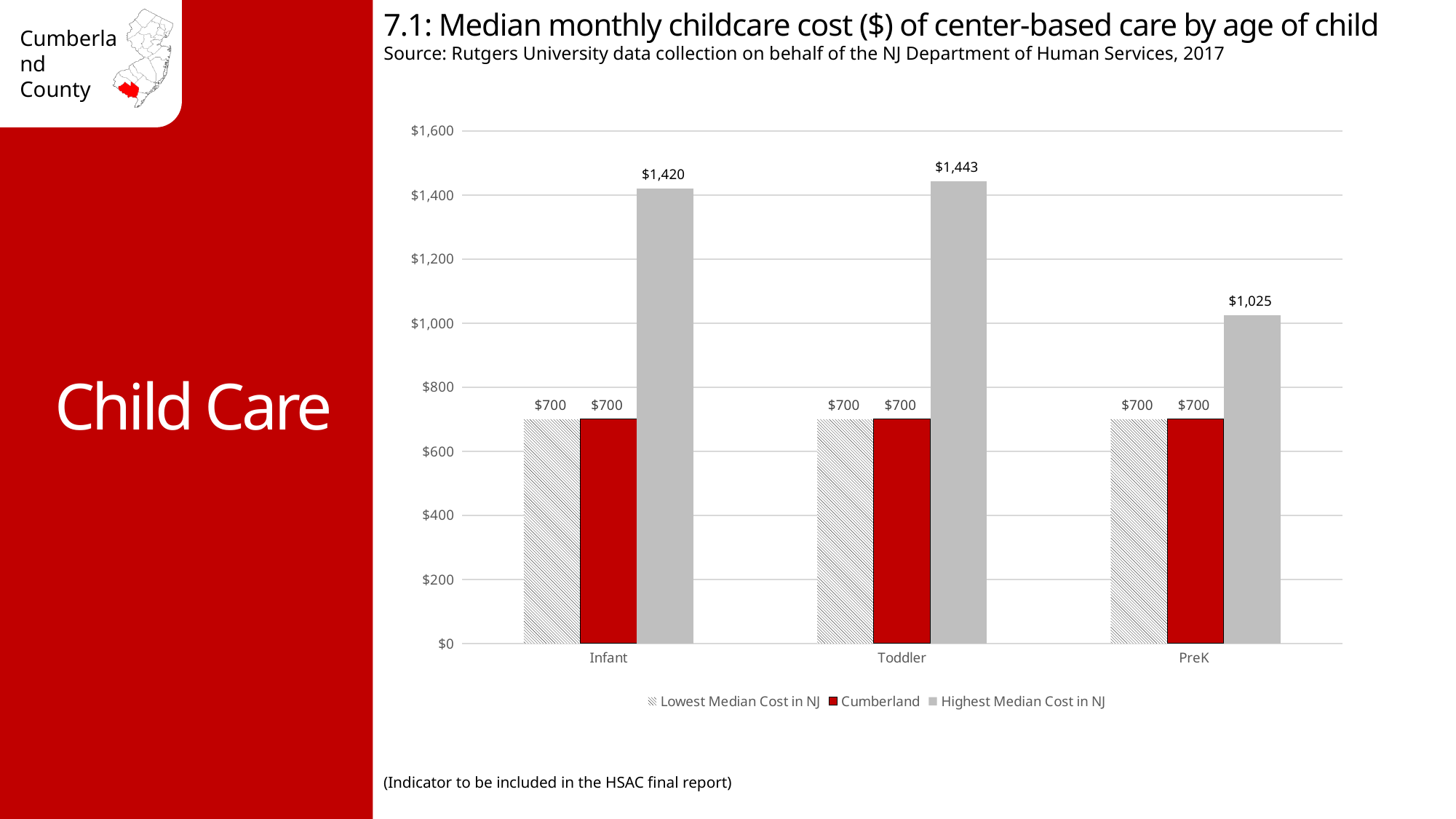
Is the Highest Median Cost in NJ for Infant care larger or smaller than for Toddler care? smaller What is the Highest Median Cost in NJ for Infant care? $1,420 How many age groups are shown on the x axis? 3 What is the difference between the Highest Median Cost in NJ for Infant care and for PreK care? $395 How many series does the legend list? 3 What is the Cumberland median monthly cost for Toddler care? $700 Which age group has the lowest value for the Highest Median Cost in NJ series? PreK What is the Highest Median Cost in NJ for PreK care? $1,025 What kind of chart is shown on the slide? bar chart Which age group has the highest value for the Highest Median Cost in NJ series? Toddler What is the difference between the Highest Median Cost in NJ and the Cumberland cost for Toddler care? $743 Is the Highest Median Cost in NJ for PreK care greater or less than $1,200? less